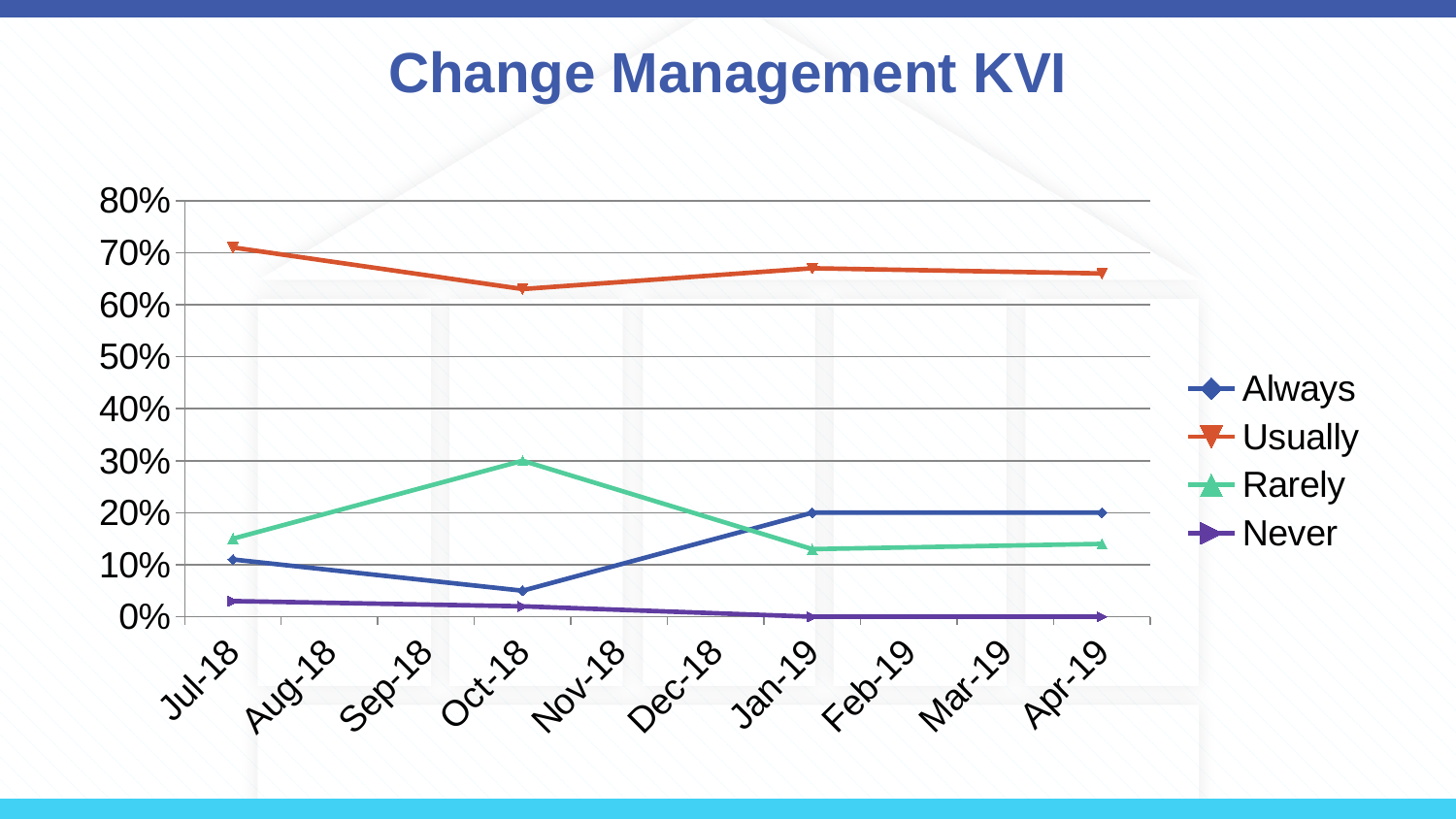
How many series does the legend list? 4 Does the Always line rise or fall from Oct-18 to Jan-19? rise At Oct-18, which is larger, the value for Rarely or the value for Always? Rarely Is the value for Always at Oct-18 greater or less than 10%? less Does the Usually line rise or fall from Jul-18 to Oct-18? fall Which series has the lowest value at Apr-19? Never Which series has the highest value at Jul-18? Usually Is the value for Usually at Oct-18 greater or less than 70%? less How many month labels are shown on the x axis? 10 What kind of chart is shown on the slide? line chart What is the title of the chart? Change Management KVI